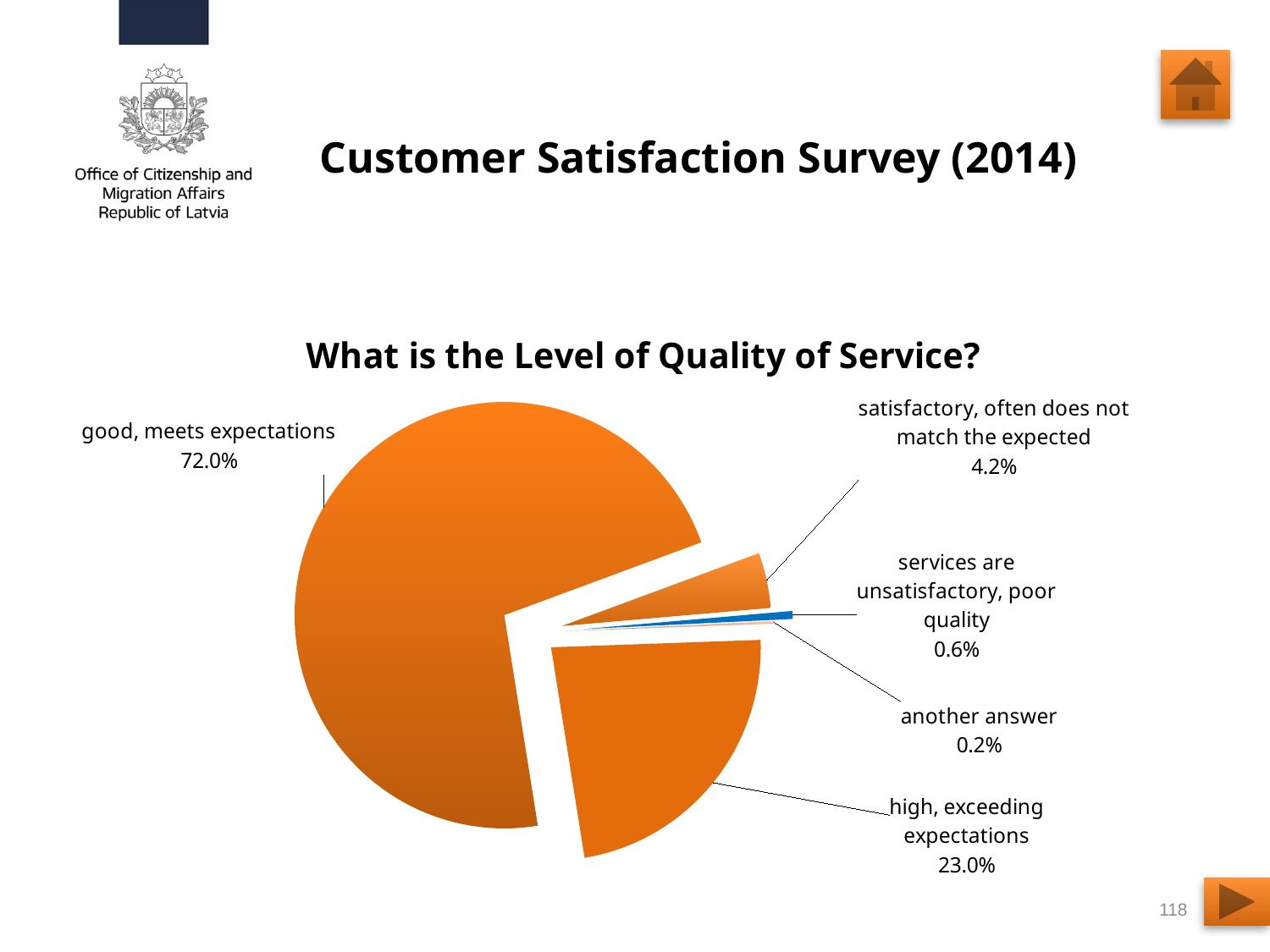
Which is larger: the share for 'satisfactory, often does not match the expected' or for 'services are unsatisfactory, poor quality'? satisfactory, often does not match the expected What is the title of the chart? What is the Level of Quality of Service? What share of respondents answered 'good, meets expectations'? 72.0% What share of respondents answered 'high, exceeding expectations'? 23.0% What share of respondents answered 'services are unsatisfactory, poor quality'? 0.6% What share of respondents gave 'another answer'? 0.2% What is the difference in percentage points between 'good, meets expectations' and 'high, exceeding expectations'? 49.0 What kind of chart is shown on the slide? pie chart Which answer has the largest share of the pie? good, meets expectations How many slices does the pie chart have? 5 What share of respondents answered 'satisfactory, often does not match the expected'? 4.2% Which answer has the smallest share of the pie? another answer